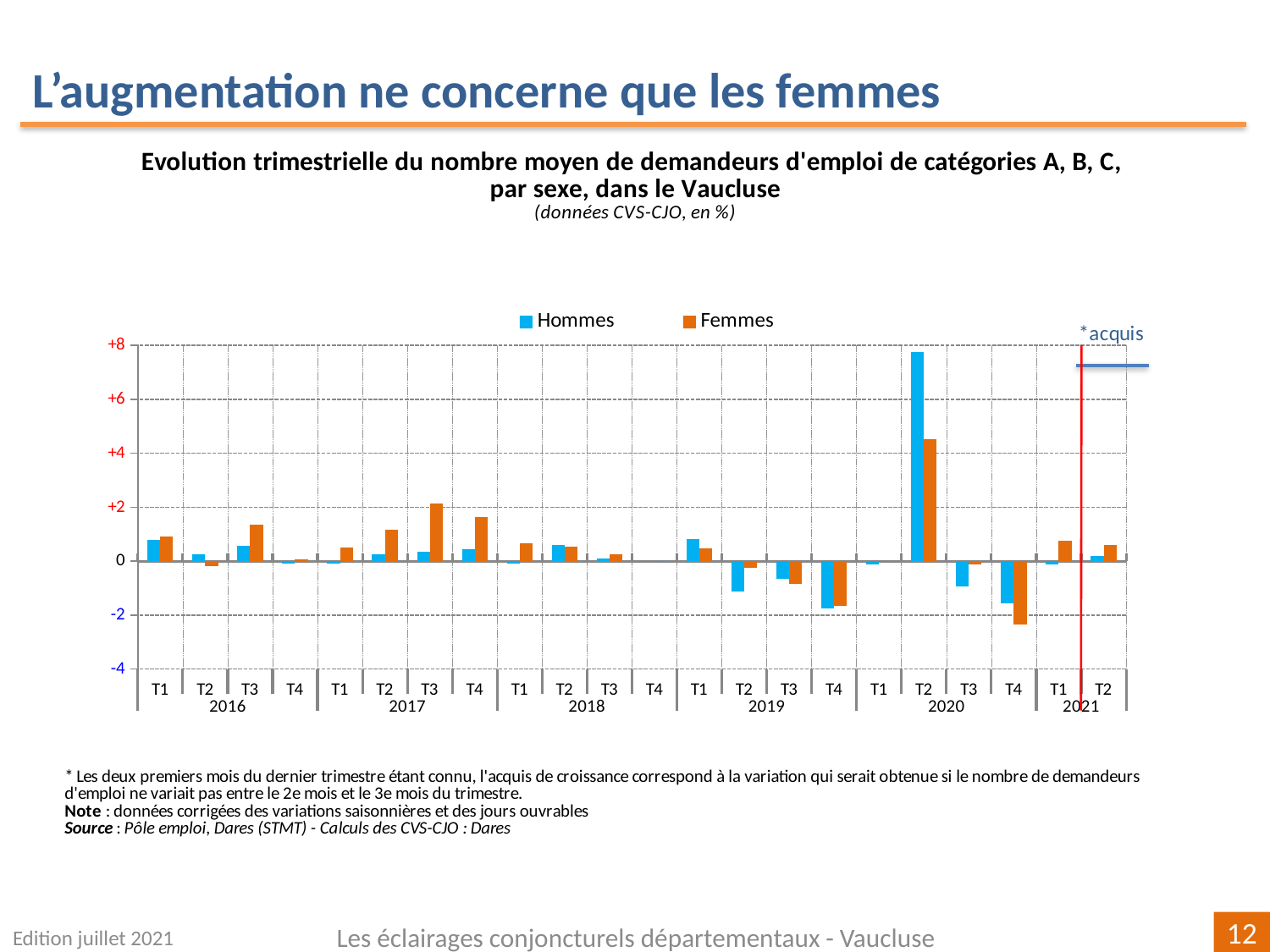
Is the value for Hommes in T2 2020 greater or less than +6? greater What label is attached to the red vertical line near the right of the chart? *acquis In T2 2020, which series has the larger value, Hommes or Femmes? Hommes In which quarter is the value for Femmes the highest? T2 2020 What kind of chart is shown on the slide? bar chart In which quarter is the value for Hommes the highest? T2 2020 In T3 2017, which series has the larger value, Hommes or Femmes? Femmes In which quarter is the value for Femmes the lowest? T4 2020 How many series does the legend list? 2 Is the value for Femmes in T4 2020 greater or less than -2? less What are the two series named in the legend? Hommes and Femmes How many quarters are shown along the x axis? 22